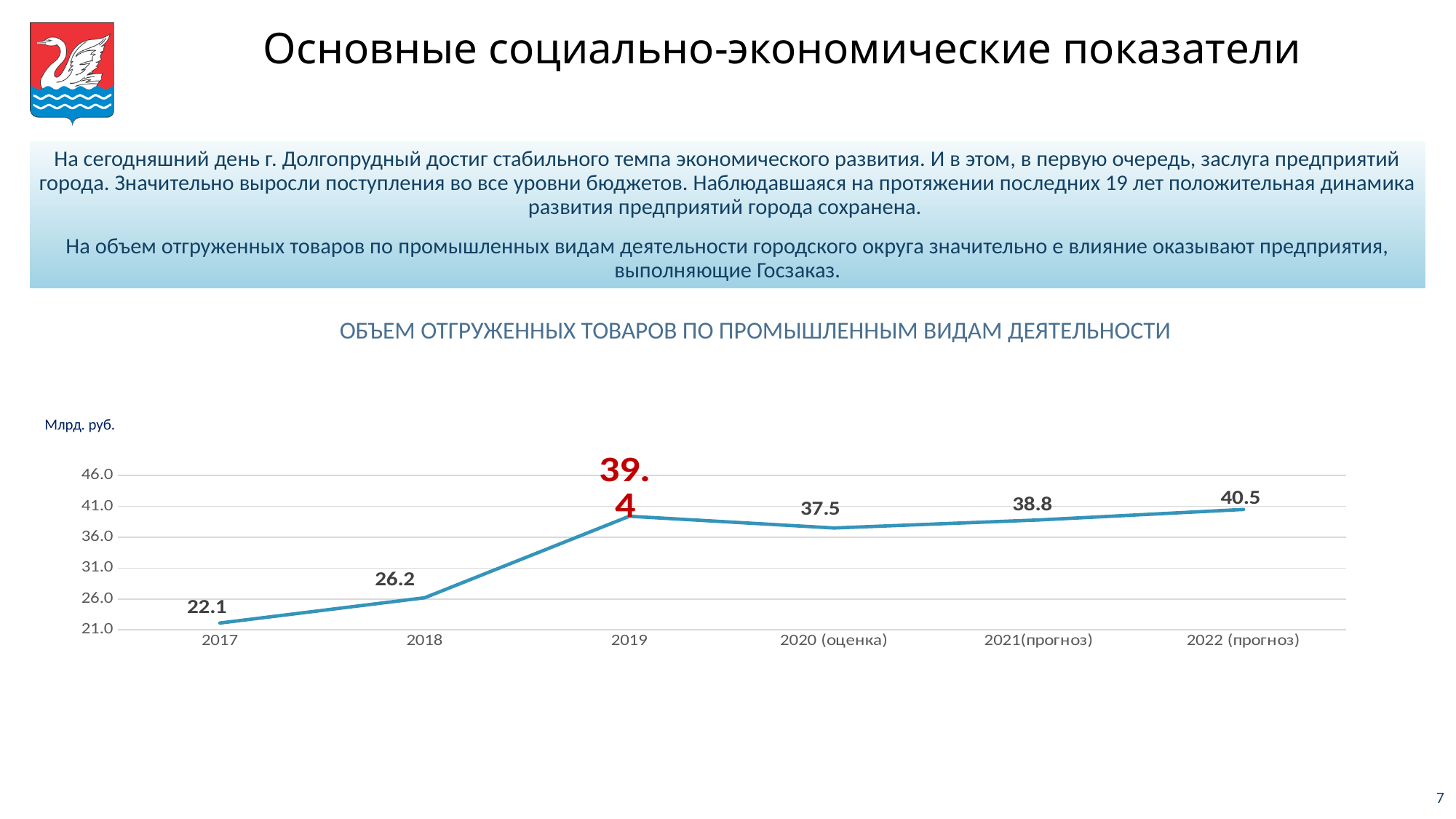
What is the value for 2019 on the chart? 39.4 What kind of chart is shown on the slide? line chart What is the difference between the values for 2019 and 2018? 13.2 What is the value for 2017 on the chart? 22.1 Is the value for 2018 greater or less than 31.0? less How many data points are plotted on the chart? 6 Which year has the lowest value on the chart? 2017 What unit is indicated for the values on the chart? Млрд. руб. What is the value for 2021(прогноз) on the chart? 38.8 Which is larger, the value for 2019 or the value for 2020 (оценка)? 2019 Which year has the highest value on the chart? 2022 (прогноз) What is the difference between the values for 2022 (прогноз) and 2017? 18.4